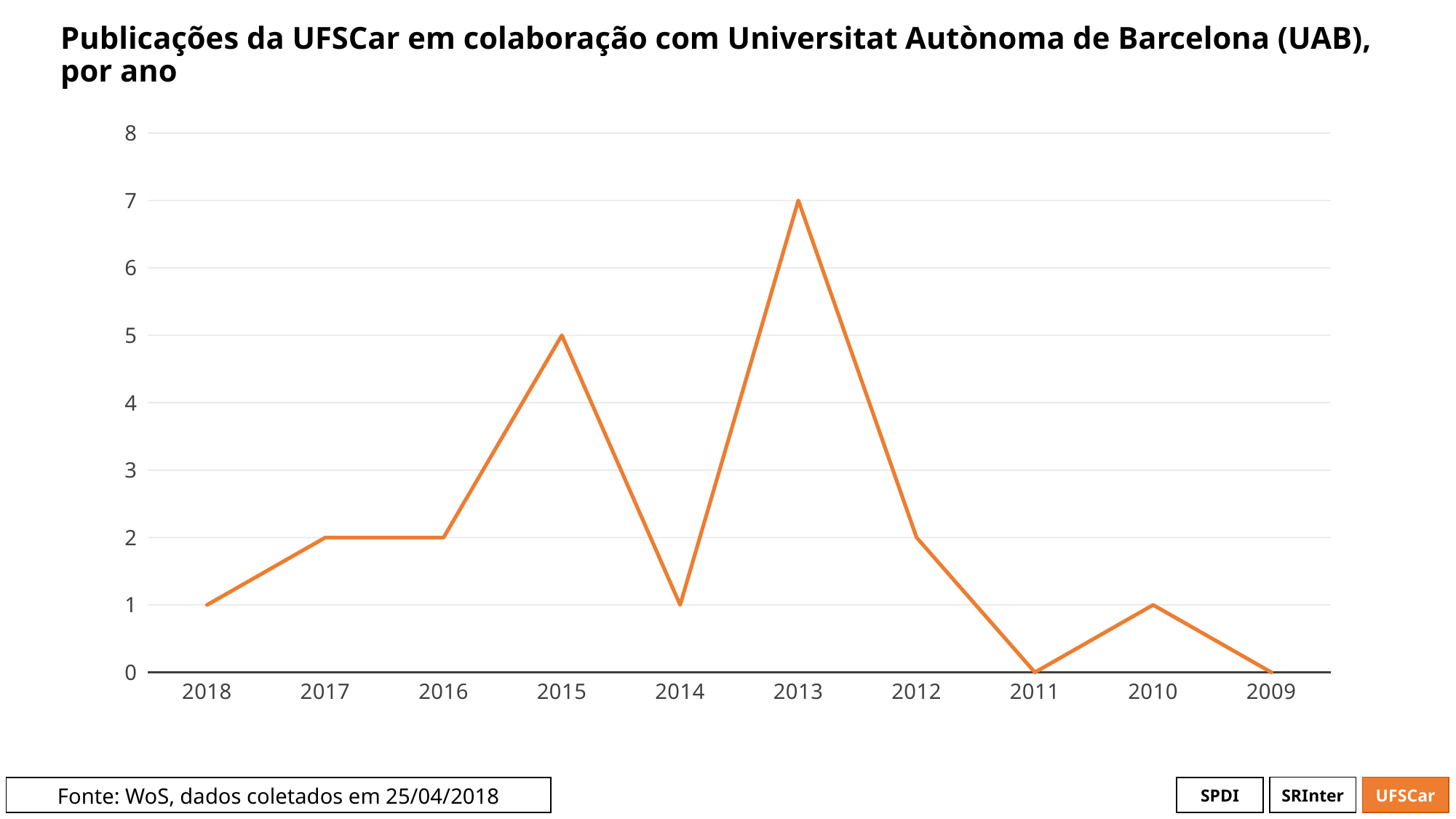
Do the values rise or fall from 2013 to 2011? Fall What is the difference between the values for 2013 and 2015? 2 How many publications are shown for 2015? 5 How many publications are shown for 2018? 1 What type of chart is shown on the slide? Line chart How many years are shown on the x axis? 10 What is the data source cited at the bottom of the slide? WoS, dados coletados em 25/04/2018 Which year has the highest number of publications? 2013 How many publications are shown for 2011? 0 Which year has the larger value, 2017 or 2014? 2017 How many publications are shown for 2013? 7 Is the value for 2013 greater or less than 6? greater